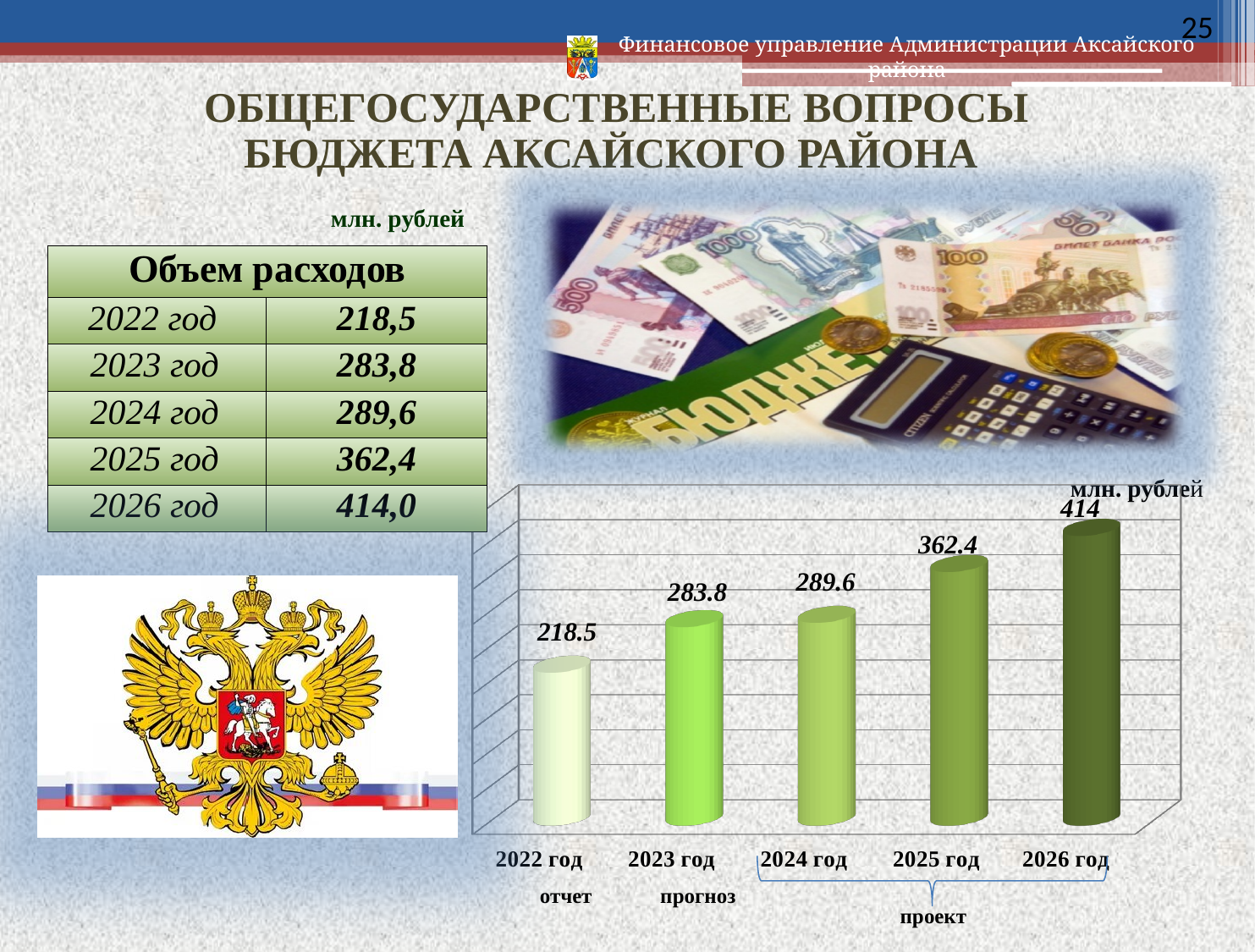
Which year has the lowest value on the chart? 2022 год What is the value shown for 2026 год on the chart? 414 Which year has the highest value on the chart? 2026 год What kind of chart is shown on the slide? Bar chart What is the value shown for 2024 год on the chart? 289.6 Which is larger, the value for 2023 год or the value for 2025 год? 2025 год What is the difference between the values for 2026 год and 2022 год? 195.5 How many years (bars) are shown on the chart? 5 What is the difference between the values for 2025 год and 2024 год? 72.8 Do the values rise or fall from 2022 год to 2026 год? Rise What unit is indicated above the chart? млн. рублей What is the value shown for 2022 год on the chart? 218.5